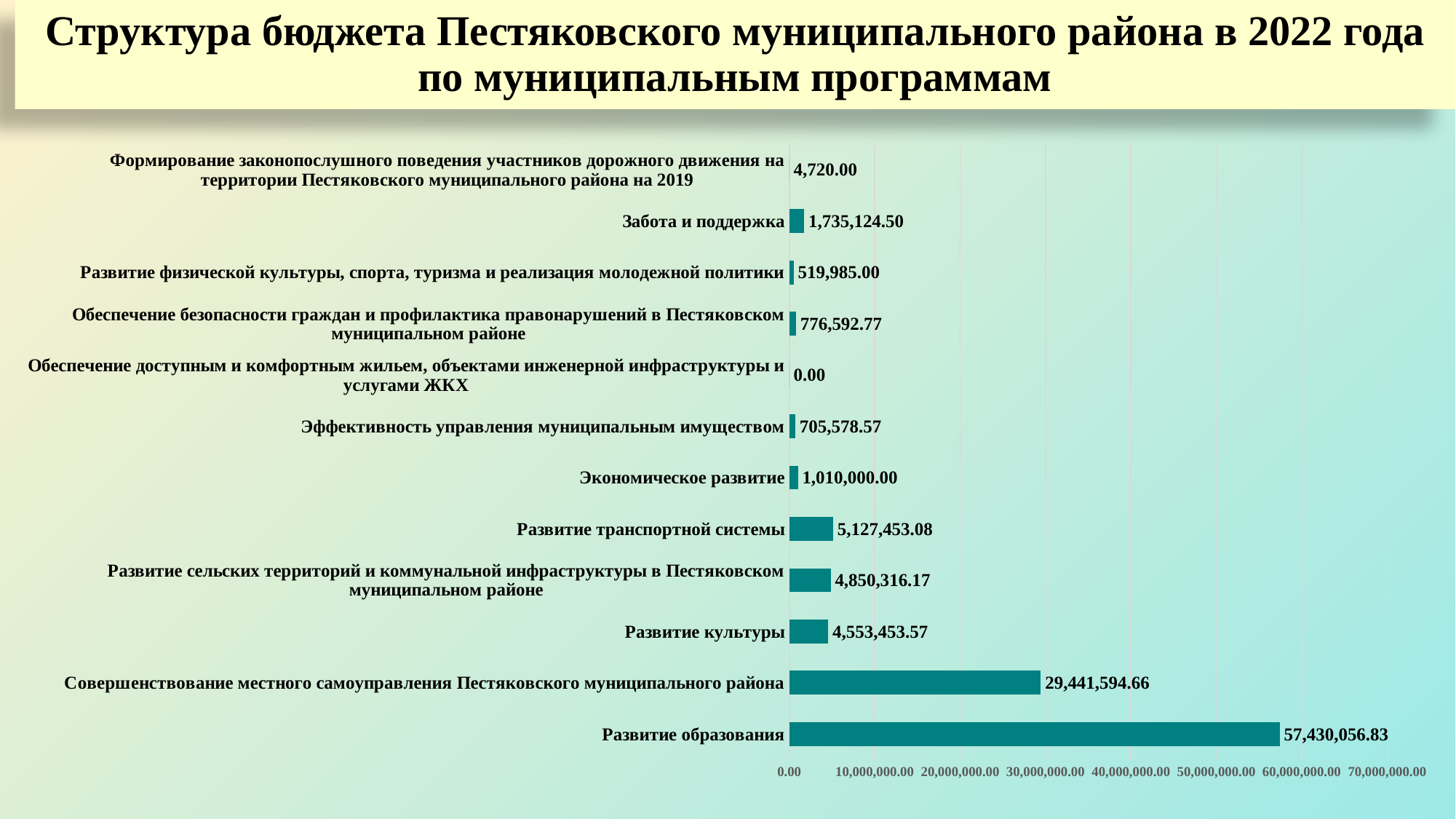
What is the difference between the values for Развитие транспортной системы and Развитие сельских территорий и коммунальной инфраструктуры в Пестяковском муниципальном районе? 277,136.91 What is the value for Совершенствование местного самоуправления Пестяковского муниципального района? 29,441,594.66 How many programs are shown in the chart? 12 What is the difference between the values for Развитие образования and Совершенствование местного самоуправления Пестяковского муниципального района? 27,988,462.17 What is the value for Развитие транспортной системы? 5,127,453.08 What is the value for Забота и поддержка? 1,735,124.50 Which program has the highest value? Развитие образования What kind of chart is shown on the slide? bar chart What is the value for Развитие образования? 57,430,056.83 Is the value for Развитие образования greater or less than 50,000,000.00? greater Which program has the lowest value? Обеспечение доступным и комфортным жильем, объектами инженерной инфраструктуры и услугами ЖКХ Which is larger: the value for Развитие культуры or the value for Развитие транспортной системы? Развитие транспортной системы